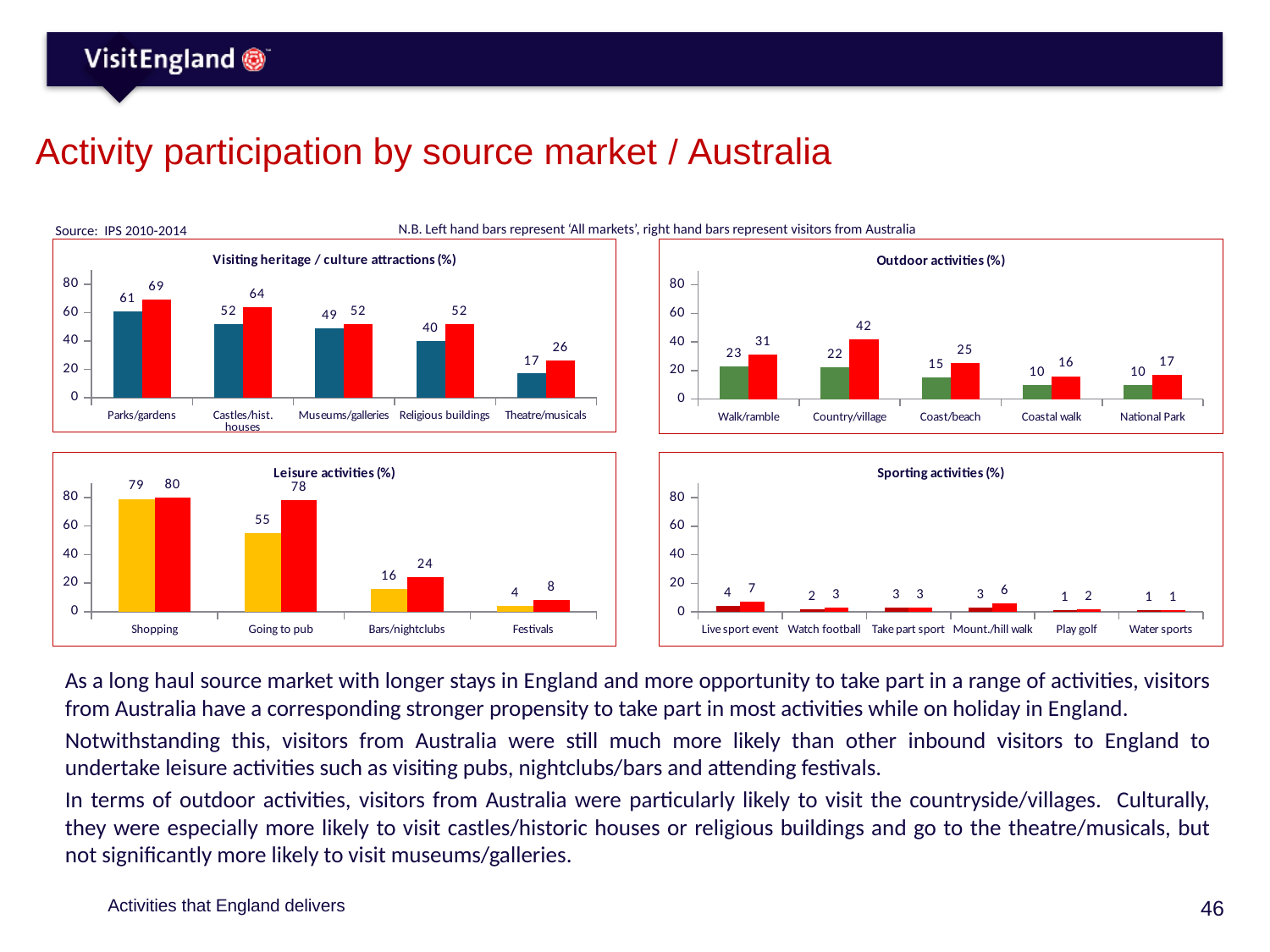
In the 'Outdoor activities (%)' chart, what is the value of the right-hand (Australia) bar for Country/village? 42 In the 'Leisure activities (%)' chart, what is the difference between the Australia bar and the All markets bar for Going to pub? 23 In the 'Sporting activities (%)' chart, what is the value of the right-hand (Australia) bar for Mount./hill walk? 6 In the 'Visiting heritage / culture attractions (%)' chart, what is the difference between the Australia bar and the All markets bar for Religious buildings? 12 How many categories are shown in the 'Outdoor activities (%)' chart? 5 In the 'Visiting heritage / culture attractions (%)' chart, which category has the lowest values? Theatre/musicals In the 'Outdoor activities (%)' chart, which category has the highest Australia value? Country/village In the 'Leisure activities (%)' chart, do the values rise or fall from Shopping to Festivals? fall What type of chart is the 'Sporting activities (%)' chart? bar chart In the 'Leisure activities (%)' chart, what is the value of the left-hand (All markets) bar for Going to pub? 55 In the 'Visiting heritage / culture attractions (%)' chart, what is the value of the right-hand (Australia) bar for Castles/hist. houses? 64 How many categories are shown in the 'Sporting activities (%)' chart? 6